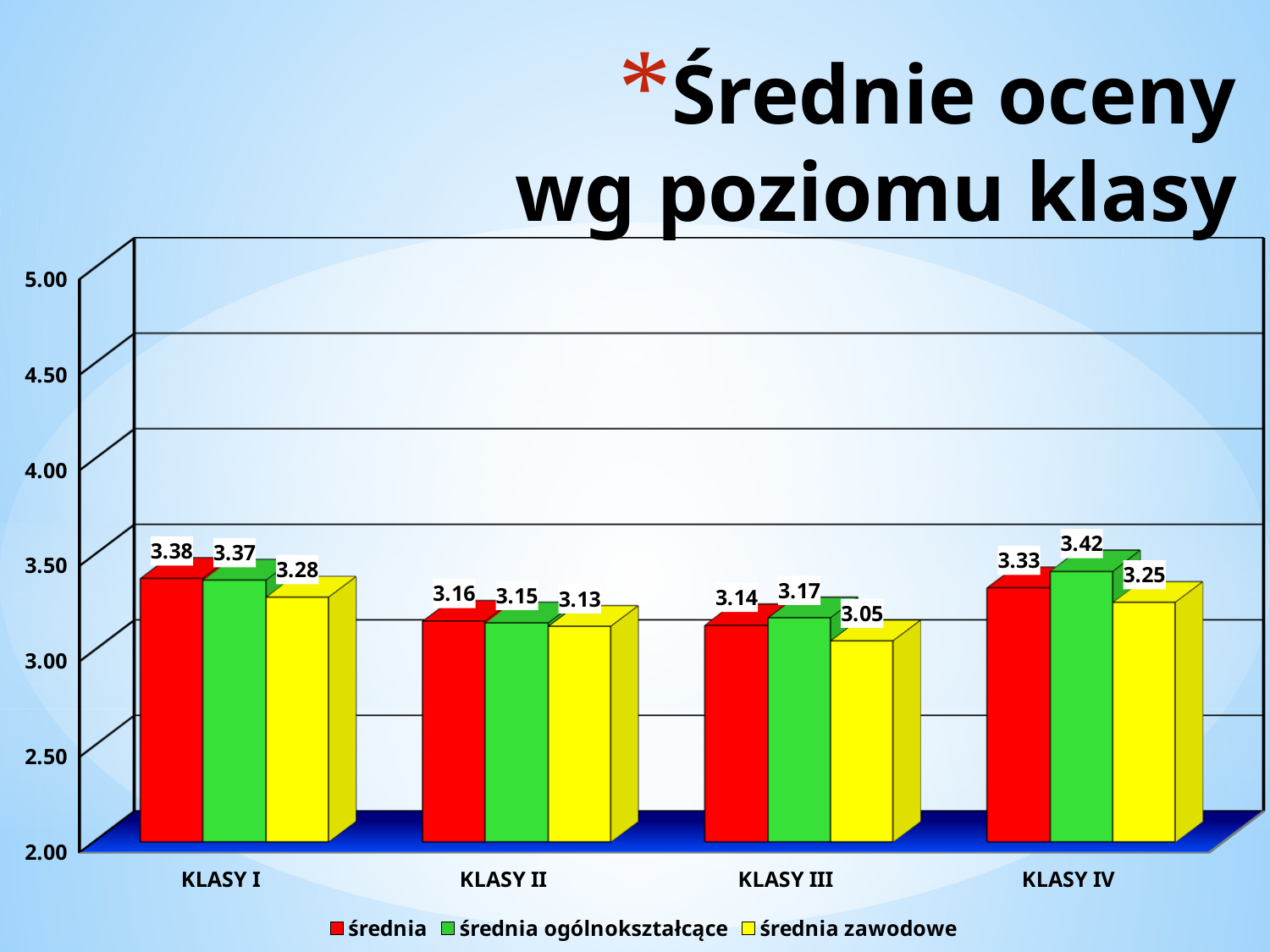
What is the difference between 'średnia ogólnokształcące' and 'średnia zawodowe' for KLASY IV? 0.17 How many series does the legend list? 3 What is the value of 'średnia zawodowe' for KLASY III? 3.05 Which is larger: 'średnia' for KLASY I or 'średnia' for KLASY IV? KLASY I How many class levels are shown on the x axis? 4 What is the value of 'średnia ogólnokształcące' for KLASY IV? 3.42 Which class level has the lowest value for 'średnia zawodowe'? KLASY III What colour represents 'średnia zawodowe' in the chart? yellow What kind of chart is shown on the slide? bar chart Is the value of 'średnia zawodowe' for KLASY II greater or less than 3.50? less Which class level has the highest value for 'średnia ogólnokształcące'? KLASY IV What is the value of 'średnia' for KLASY I? 3.38